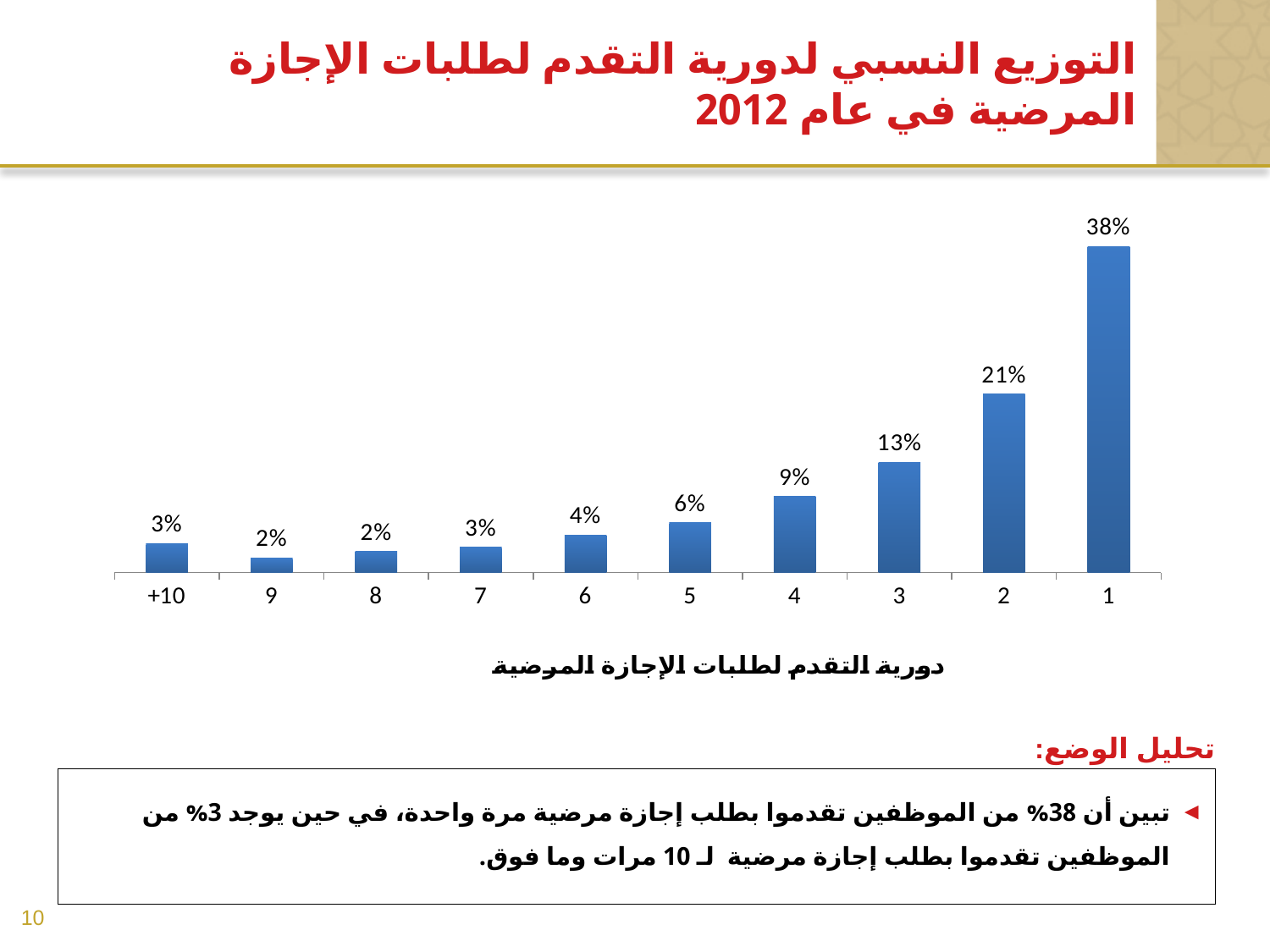
Do the values generally rise or fall moving from left (+10) to right (1) along the x axis? Rise Which category has the highest percentage in the chart? 1 What percentage is shown for category 5 in the chart? 6% Which has a larger percentage, category 7 or category 9? 7 Which has a larger percentage, category 3 or category 4? 3 What percentage is shown for category +10 in the chart? 3% What kind of chart is shown on the slide? Bar chart What percentage is shown for category 1 in the chart? 38% What is the difference between the percentages for category 4 and category 6? 5% What percentage is shown for category 3 in the chart? 13% What is the difference between the percentages for category 1 and category 2? 17% How many categories are shown on the x axis of the chart? 10